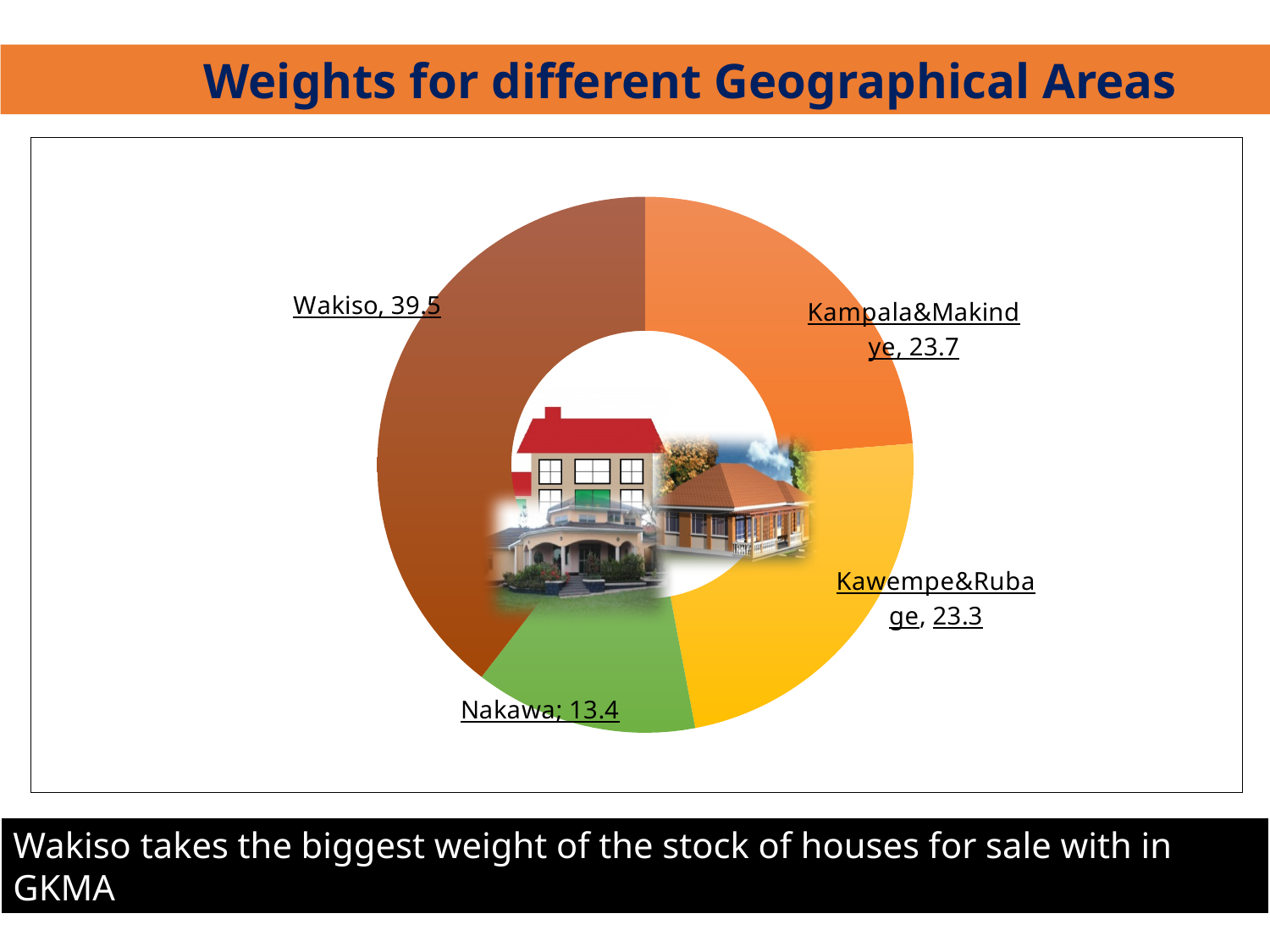
Which geographical area has the largest weight? Wakiso How many geographical areas are shown in the chart? 4 What kind of chart is shown on the slide? Doughnut (pie) chart What is the difference between the weights of Wakiso and Nakawa? 26.1 What is the value shown for Kawempe&Rubage? 23.3 What is the value shown for Kampala&Makindye? 23.7 What is the value shown for Nakawa? 13.4 What is the value shown for Wakiso? 39.5 What is the difference between the weights of Kampala&Makindye and Kawempe&Rubage? 0.4 Which has the larger weight, Wakiso or Kampala&Makindye? Wakiso Which geographical area has the smallest weight? Nakawa What is the title of the slide containing the chart? Weights for different Geographical Areas